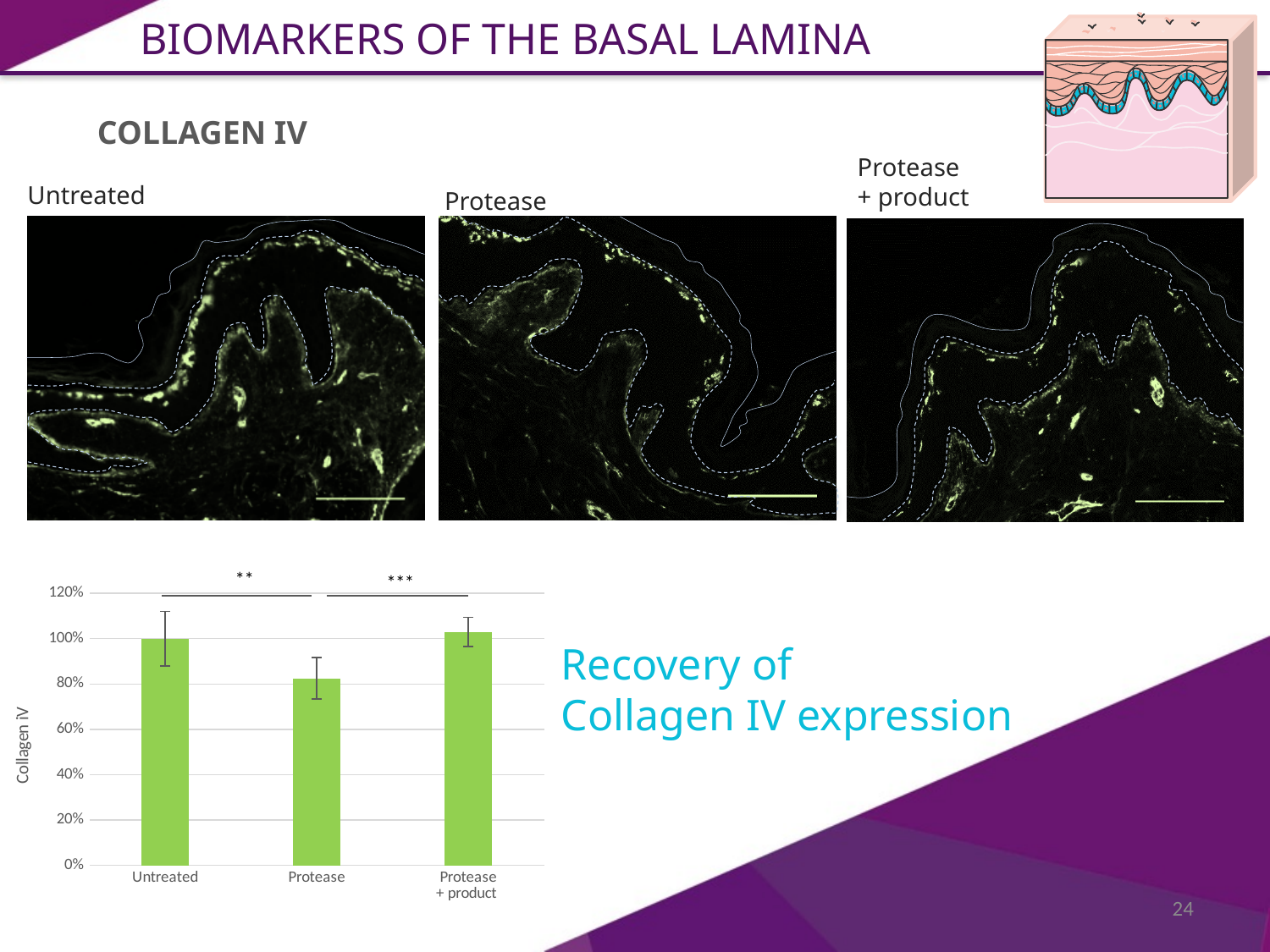
What is the label on the y axis of the bar chart? Collagen iV Is the value for Untreated greater or less than 80%? greater Is the value for Protease greater or less than 100%? less Which is larger in the bar chart, the value for Untreated or the value for Protease? Untreated What kind of chart is shown at the bottom left of the slide? bar chart What colour are the bars in the bar chart? green Which is larger in the bar chart, the value for Protease + product or the value for Protease? Protease + product Which category has the lowest value in the bar chart? Protease How many categories are plotted on the x axis of the bar chart? 3 Is the value for Protease + product greater or less than 80%? greater What is the value for Untreated in the bar chart? 100%